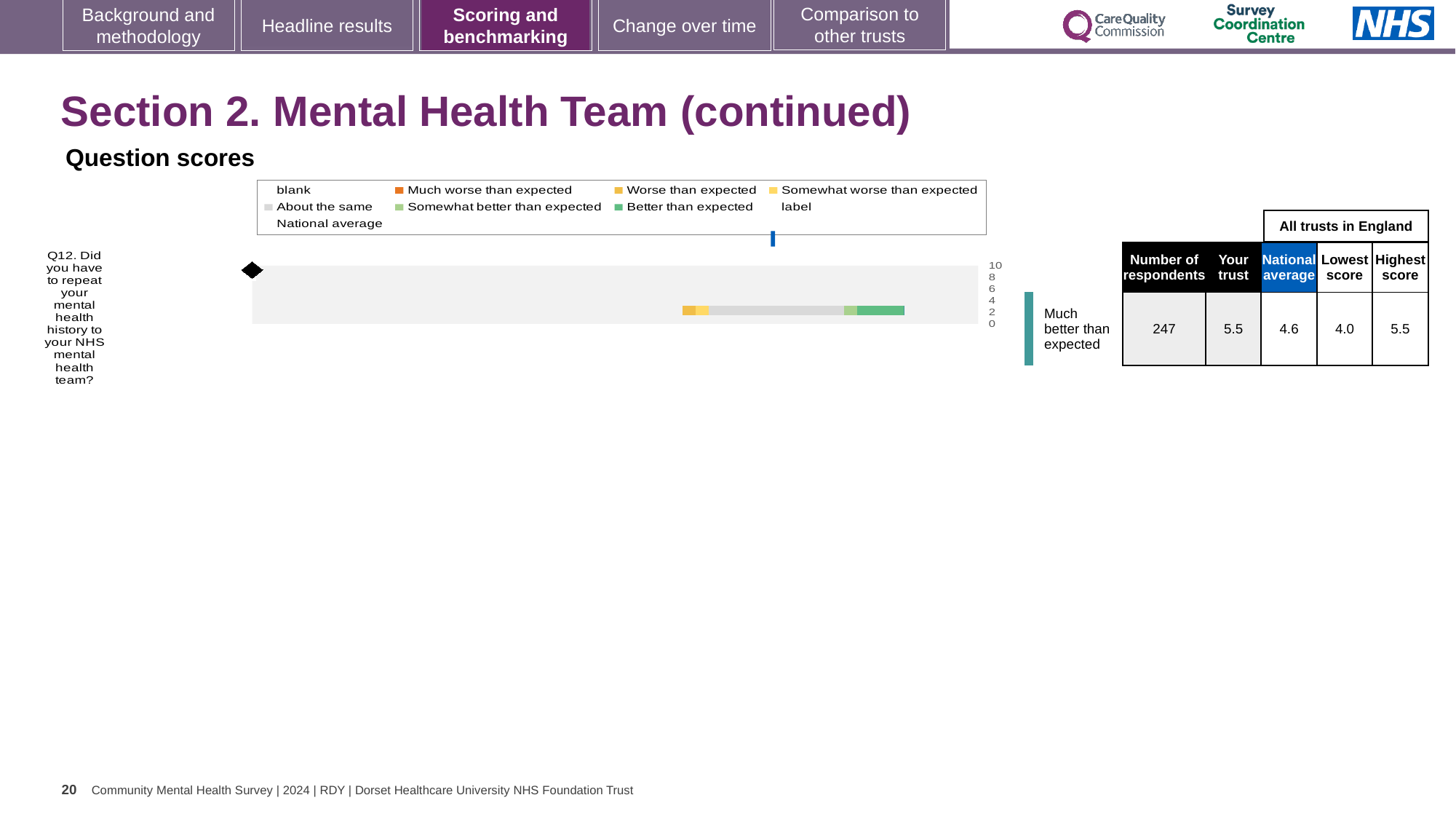
What is the highest score among all trusts in England for Q12? 5.5 Which question number is plotted on the chart? Q12 What benchmark category is shown next to the Q12 bar? Much better than expected What is the national average score for Q12? 4.6 What is the lowest score among all trusts in England for Q12? 4.0 How many questions are plotted on the chart? 1 What is the 'Your trust' score for Q12? 5.5 What kind of chart is used to show the Q12 question score? bar chart How many respondents answered Q12? 247 Which is larger for Q12, the 'Your trust' score or the national average? Your trust What is the difference between the 'Your trust' score and the national average for Q12? 0.9 What is the difference between the highest and lowest scores among all trusts in England for Q12? 1.5